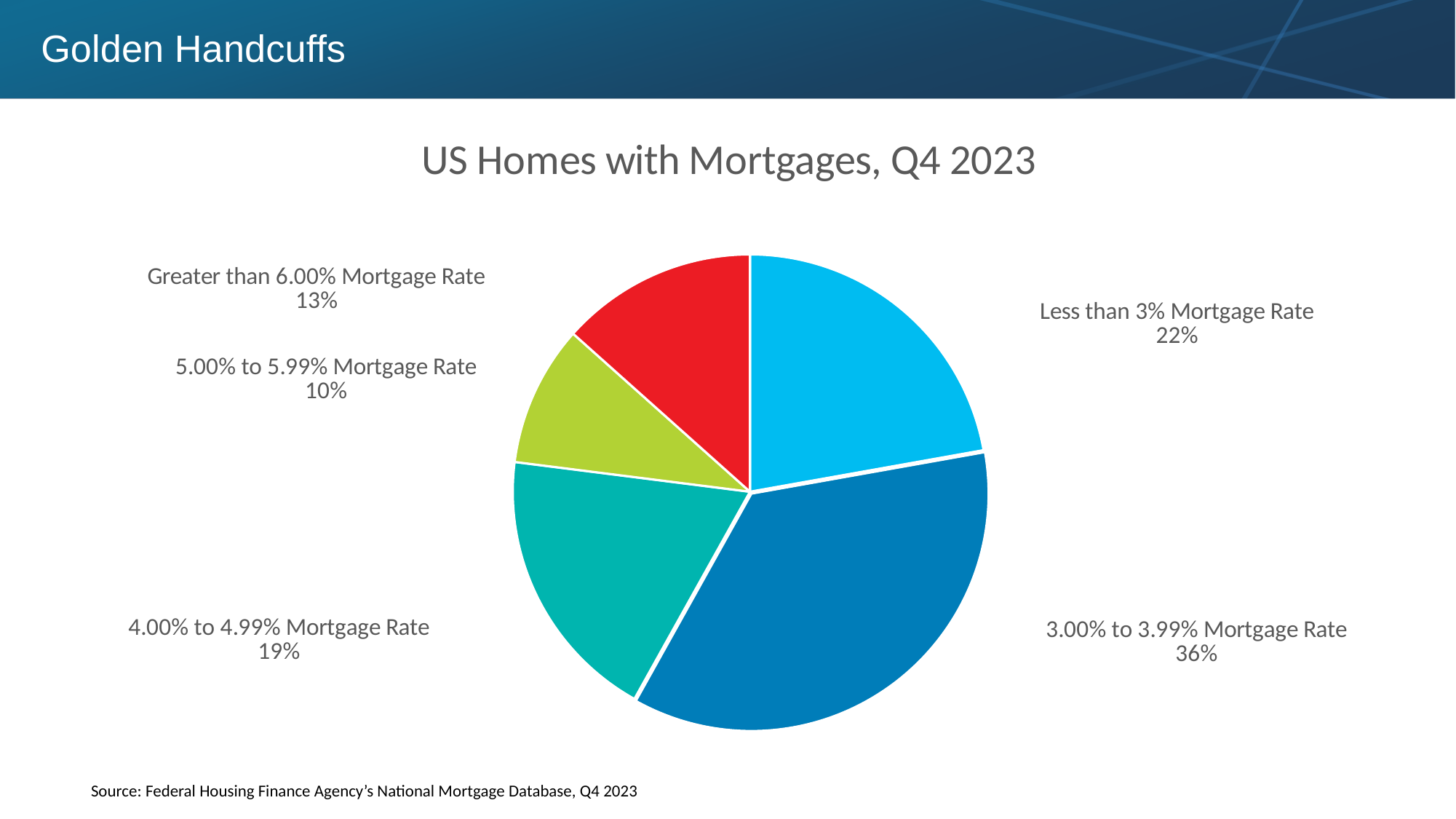
What share of US homes with mortgages have a mortgage rate greater than 6.00%? 13% What share of US homes with mortgages have a 5.00% to 5.99% mortgage rate? 10% What is the title of the chart? US Homes with Mortgages, Q4 2023 What share of US homes with mortgages have a 3.00% to 3.99% mortgage rate? 36% Which mortgage rate category has the smallest share of US homes with mortgages? 5.00% to 5.99% Mortgage Rate What kind of chart is shown on the slide? Pie chart What is the combined share of homes with a mortgage rate below 4%? 58% How many mortgage rate categories are shown in the pie chart? 5 What is the difference in percentage points between the 3.00% to 3.99% and the 4.00% to 4.99% mortgage rate categories? 17 Which mortgage rate category has the largest share of US homes with mortgages? 3.00% to 3.99% Mortgage Rate What share of US homes with mortgages have a mortgage rate less than 3%? 22% Which is larger: the share of homes with a mortgage rate less than 3% or the share with a 4.00% to 4.99% mortgage rate? Less than 3% Mortgage Rate